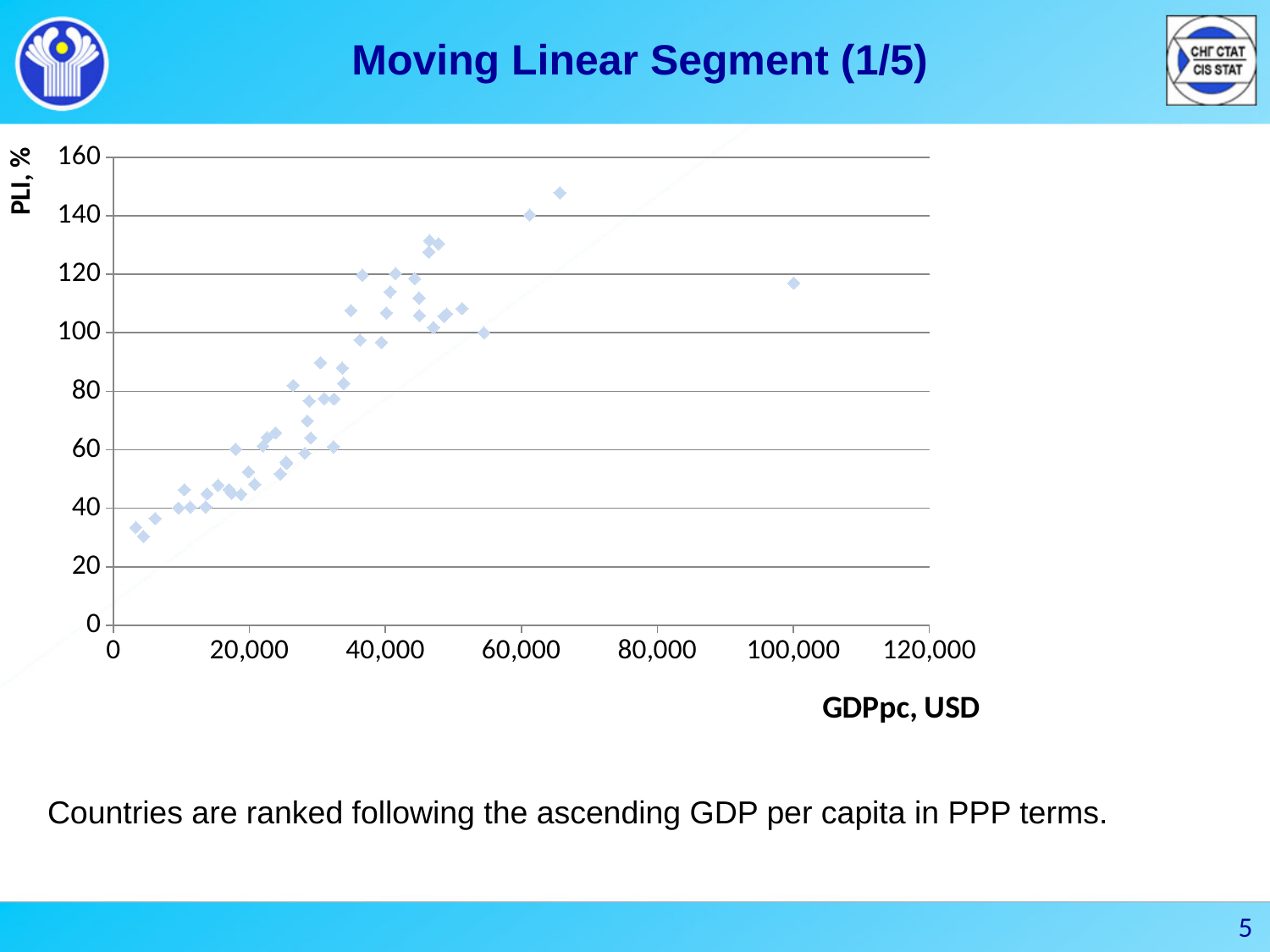
Is the PLI value of the highest point on the chart greater or less than 140? greater Is the GDPpc of the rightmost point on the chart greater or less than 80,000? greater Overall, does PLI rise or fall as GDPpc increases along the x axis? rise Is the PLI value of the lowest point on the chart greater or less than 40? less What is the label of the horizontal axis of the chart? GDPpc, USD What kind of chart is shown on the slide? scatter plot What is the label of the vertical axis of the chart? PLI, % Which has the higher PLI: the point with the highest GDPpc (near 100,000 USD) or the point with the highest PLI (near 65,000 USD)? the point near 65,000 USD